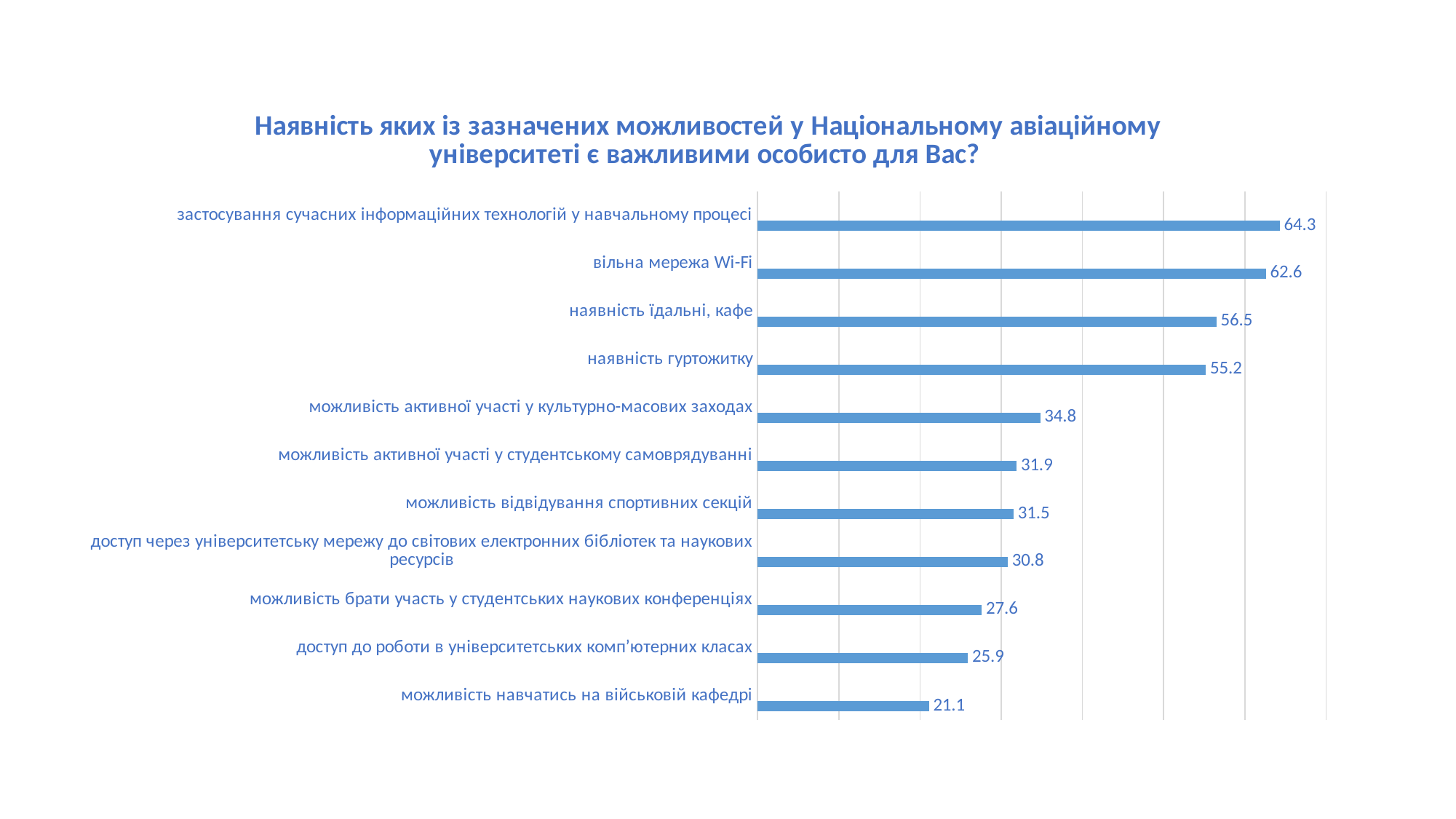
How many categories are shown in the chart? 11 What is the title of the chart? Наявність яких із зазначених можливостей у Національному авіаційному університеті є важливими особисто для Вас? What is the difference between the values for "наявність їдальні, кафе" and "наявність гуртожитку"? 1.3 Which is larger: the value for "можливість активної участі у культурно-масових заходах" or the value for "доступ до роботи в університетських комп’ютерних класах"? можливість активної участі у культурно-масових заходах What is the difference between the values for "застосування сучасних інформаційних технологій у навчальному процесі" and "можливість навчатись на військовій кафедрі"? 43.2 What kind of chart is shown on the slide? bar chart Which category has the lowest value? можливість навчатись на військовій кафедрі What is the value for "можливість брати участь у студентських наукових конференціях"? 27.6 What is the value for "наявність гуртожитку"? 55.2 What is the value for "можливість навчатись на військовій кафедрі"? 21.1 Which category has the highest value? застосування сучасних інформаційних технологій у навчальному процесі What is the value for "вільна мережа Wi-Fi"? 62.6